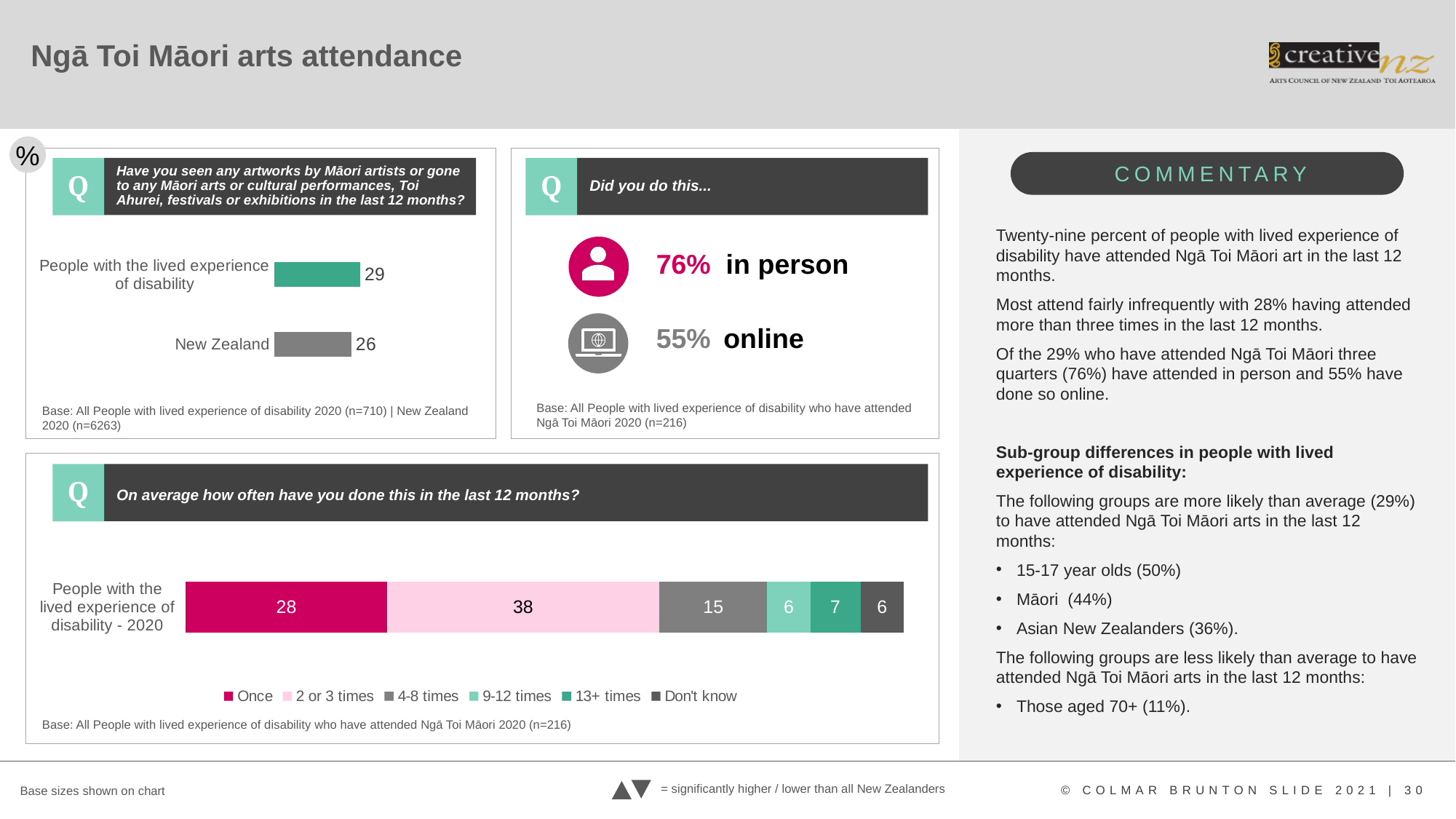
In the top-left chart on Māori arts attendance, what is the difference between the value for People with the lived experience of disability and the value for New Zealand? 3 In the bottom chart on how often people have done this in the last 12 months, how many series does the legend list? 6 In the top-left chart on Māori arts attendance, what is the value for People with the lived experience of disability? 29 In the bottom chart on how often people have done this in the last 12 months, which segment has the largest value? 2 or 3 times In the bottom chart on how often people have done this in the last 12 months, what is the value for 2 or 3 times? 38 In the top-left chart on Māori arts attendance, which category has the higher value? People with the lived experience of disability In the top-left chart on Māori arts attendance, what is the value for New Zealand? 26 In the bottom chart on how often people have done this in the last 12 months, what is the value for 4-8 times? 15 In the bottom chart on how often people have done this in the last 12 months, which is larger: the value for Once or the value for 13+ times? Once What kind of chart is the top-left chart on Māori arts attendance? Bar chart In the bottom chart on how often people have done this in the last 12 months, what is the total of the stacked bar for People with the lived experience of disability - 2020? 100 In the top-left chart on Māori arts attendance, how many categories are shown? 2